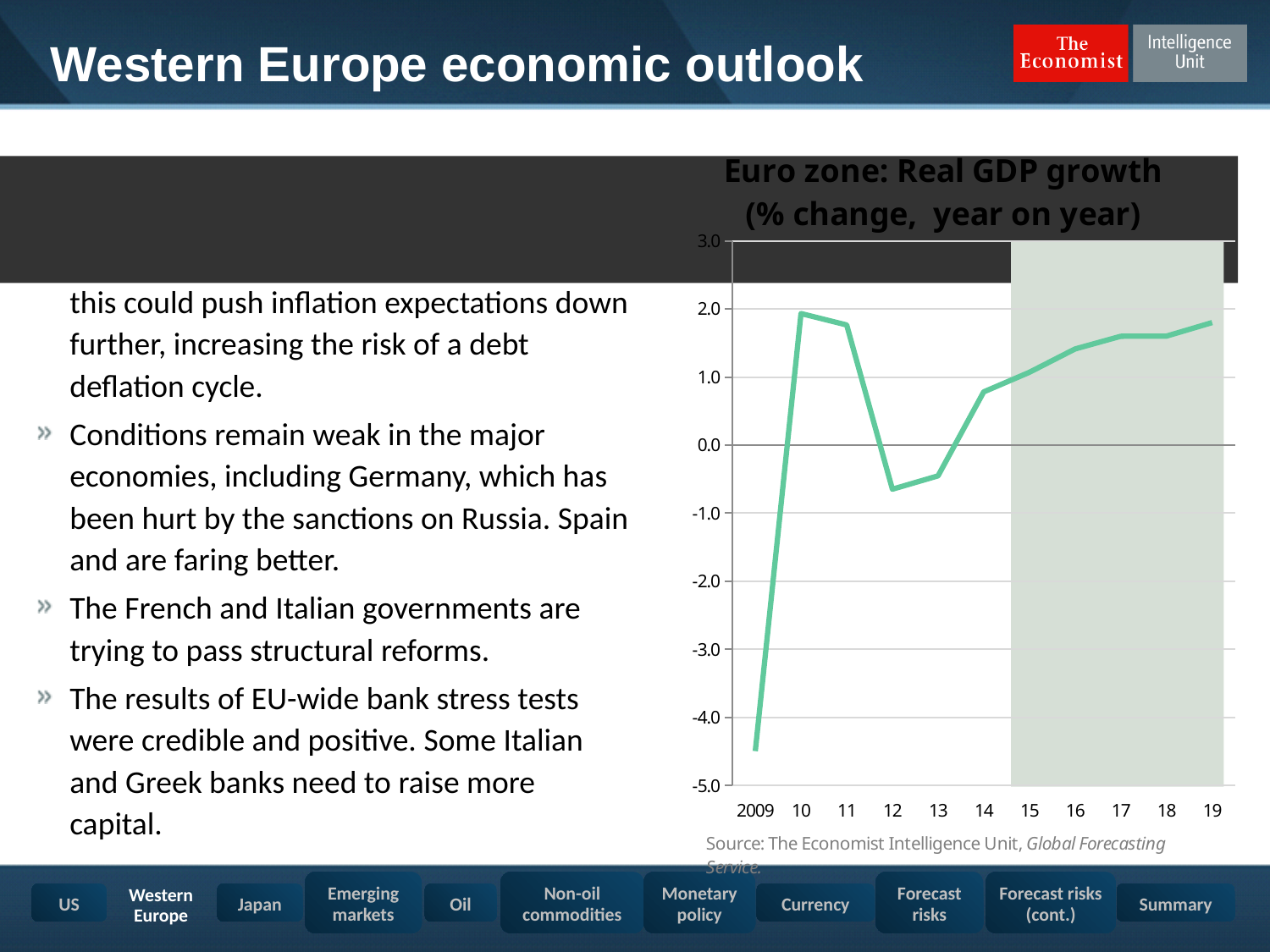
What is the lowest value shown on the y axis of the chart? -5.0 What kind of chart is shown on the slide? line chart Is the value for 2016 greater or less than 1.0? greater What is the title of the chart? Euro zone: Real GDP growth (% change, year on year) Which year has the lowest real GDP growth in the chart? 2009 Is the value for 2012 greater or less than 0.0? less Do the values rise or fall from 2013 to 2019? rise Which year has the larger real GDP growth, 2010 or 2012? 2010 How many years are plotted along the x axis of the chart? 11 Which year has the highest real GDP growth in the chart? 2010 Is the value for 2009 greater or less than -4.0? less